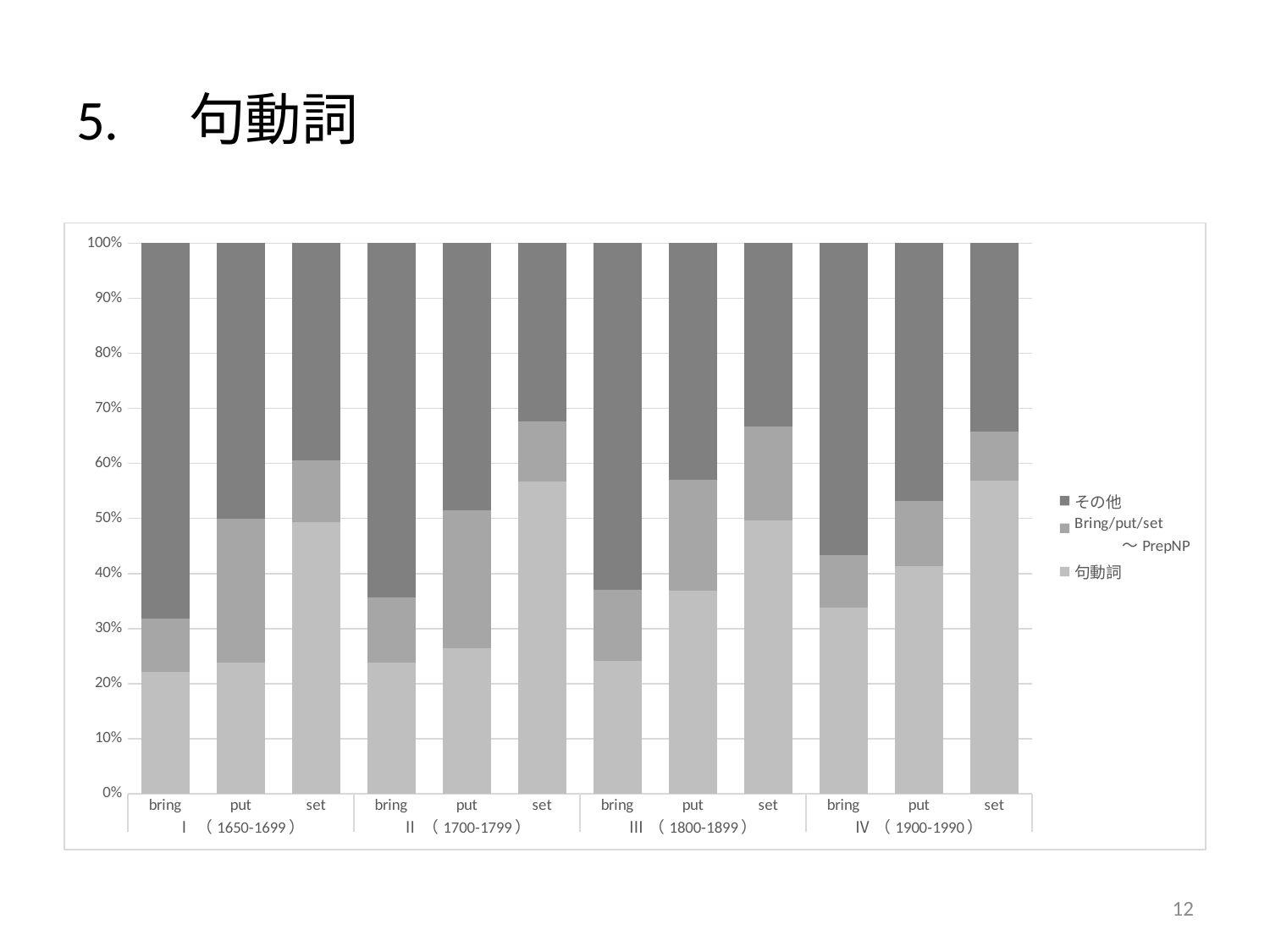
How many bars are plotted in the chart? 12 How many time periods are shown along the x axis? 4 In period I (1650-1699), which has the larger 句動詞 share, bring or set? set What kind of chart is shown on the slide? stacked bar chart How many series does the legend list? 3 Is the 句動詞 share for bring in period IV (1900-1990) greater or less than 30%? greater Is the 句動詞 share for bring in period I (1650-1699) greater or less than 30%? less In period IV (1900-1990), which verb has the largest 句動詞 share? set Which legend entry is shown with the darkest shade? その他 Is the 句動詞 share for set in period II (1700-1799) greater or less than 50%? greater Which period label covers the years 1800-1899? III In period I (1650-1699), which verb has the smallest 句動詞 share? bring